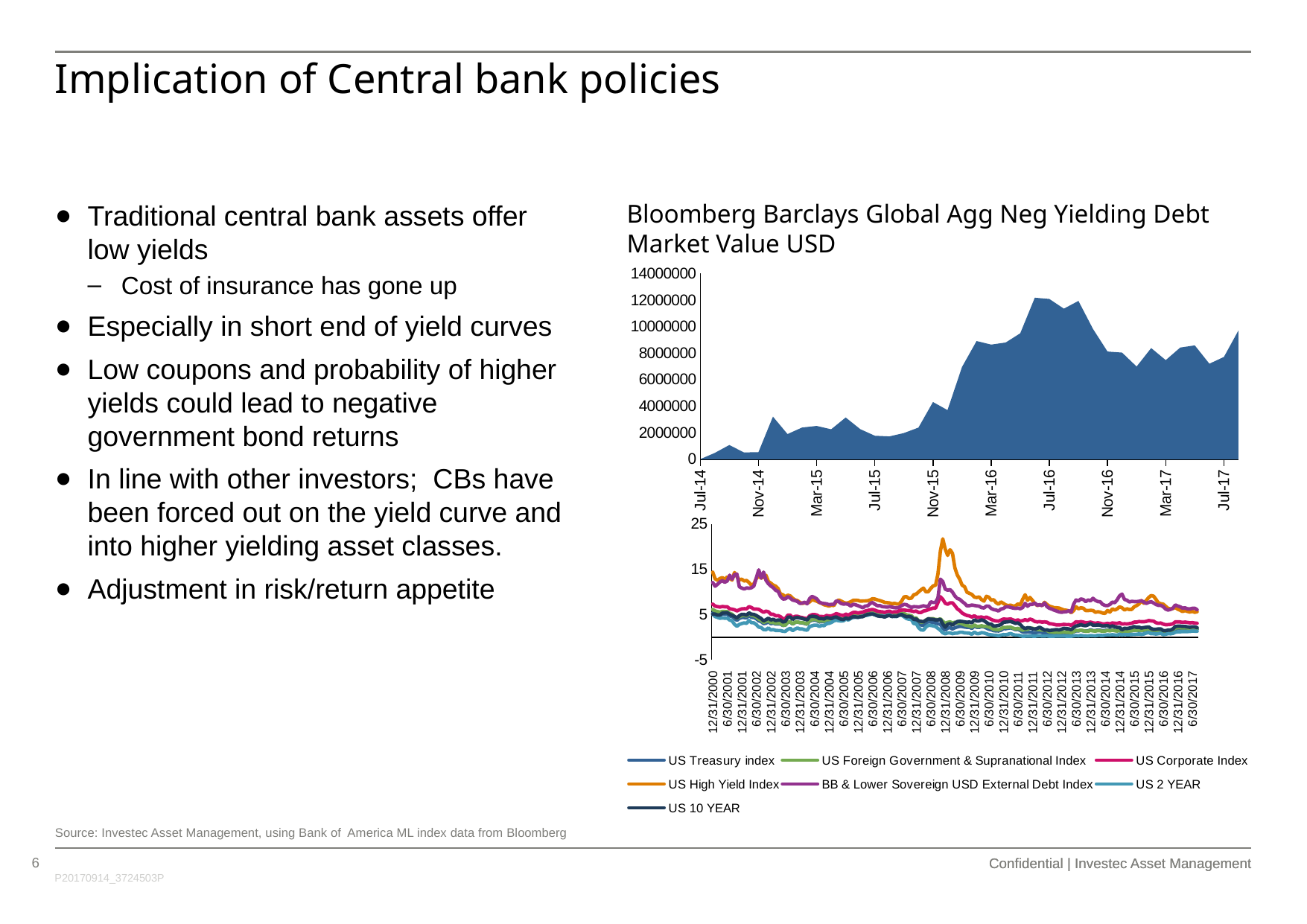
In the top chart, is the value at Nov-15 greater or less than 6000000? less In the top chart, do the values overall rise or fall from Jul-14 to Jul-17? rise In the bottom chart, is the peak value of the US High Yield Index around 12/31/2008 greater or less than 15? greater What is the title of the top chart? Bloomberg Barclays Global Agg Neg Yielding Debt Market Value USD How many series does the legend of the bottom chart list? 7 What kind of chart is the bottom chart showing the US index yields? Line chart In the bottom chart, which series reaches the highest value around 12/31/2008? US High Yield Index How many date labels are shown on the x axis of the top chart? 10 In the top chart, is the value at Jul-14 greater or less than 2000000? less What kind of chart is the top chart titled 'Bloomberg Barclays Global Agg Neg Yielding Debt Market Value USD'? Area chart